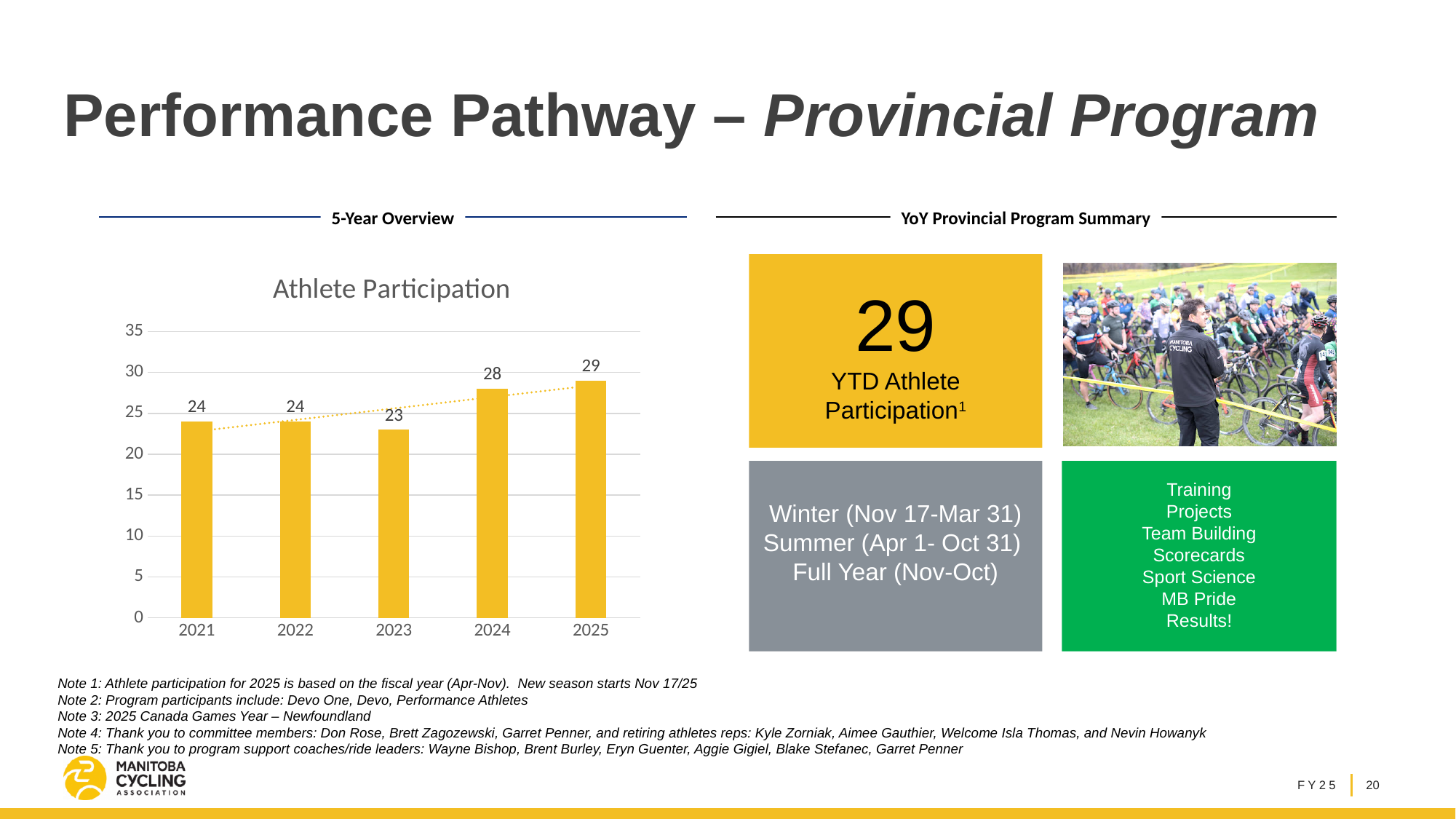
What is the athlete participation value for 2021? 24 Which year has higher athlete participation, 2024 or 2023? 2024 How many years are shown on the x axis of the Athlete Participation chart? 5 What is the difference in athlete participation between 2025 and 2023? 6 What is the difference in athlete participation between 2024 and 2022? 4 Is the athlete participation value for 2024 greater or less than 25? greater What is the athlete participation value for 2025? 29 Which year has the lowest athlete participation? 2023 What kind of chart is the Athlete Participation chart? bar chart What is the athlete participation value for 2023? 23 Which year has the highest athlete participation? 2025 What is the title of the chart on the slide? Athlete Participation